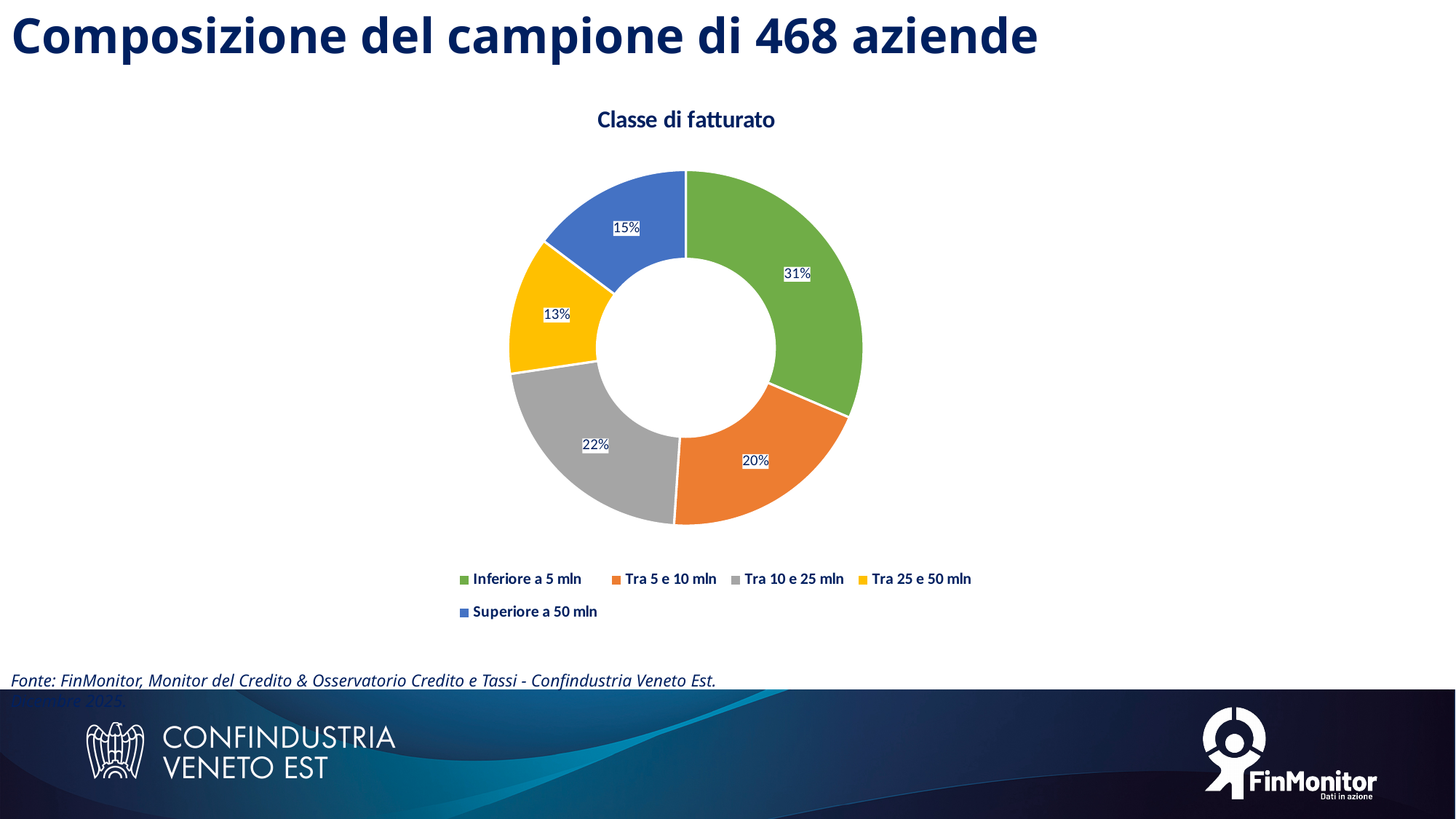
What share of the sample is in the 'Tra 25 e 50 mln' revenue class? 13% What is the difference in percentage points between the 'Inferiore a 5 mln' and 'Tra 5 e 10 mln' shares? 11 percentage points What share of the sample is in the 'Inferiore a 5 mln' revenue class? 31% Which has a larger share: 'Tra 10 e 25 mln' or 'Superiore a 50 mln'? Tra 10 e 25 mln How many revenue classes are shown in the chart? 5 What share of the sample is in the 'Tra 10 e 25 mln' revenue class? 22% Which revenue class has the largest share of the sample? Inferiore a 5 mln Which revenue class has the smallest share of the sample? Tra 25 e 50 mln What kind of chart is shown on the slide? Doughnut (pie) chart What is the title of the chart? Classe di fatturato